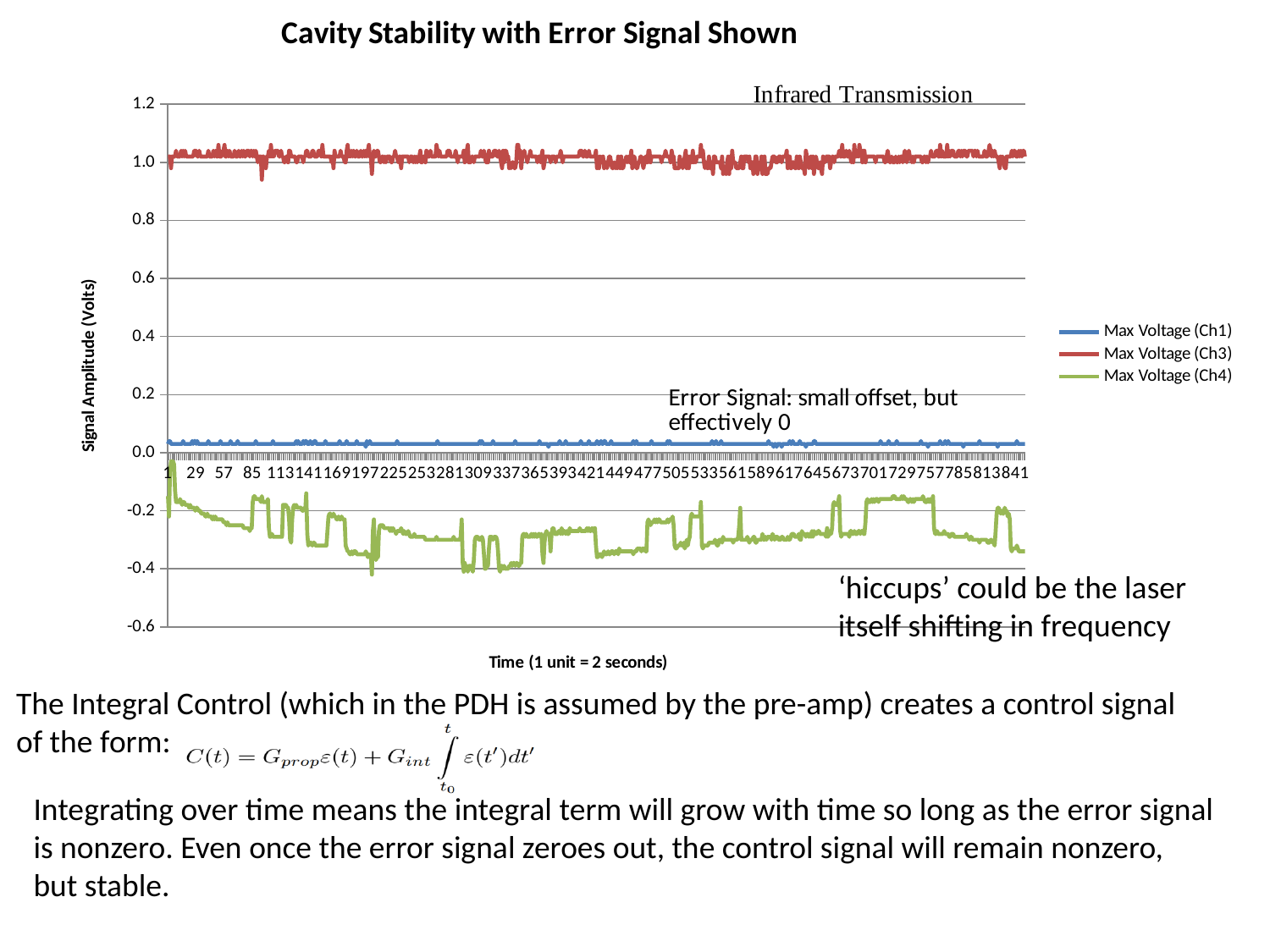
Are the values for Max Voltage (Ch4) greater or less than 0.0? less Are the values for Max Voltage (Ch3) greater or less than 0.8? greater Which series is plotted with the lowest values throughout the chart? Max Voltage (Ch4) Which series has larger values, Max Voltage (Ch3) or Max Voltage (Ch1)? Max Voltage (Ch3) Which series has larger values, Max Voltage (Ch1) or Max Voltage (Ch4)? Max Voltage (Ch1) Are the values for Max Voltage (Ch4) greater or less than -0.6? greater What kind of chart is shown on the slide? line chart What is the label of the vertical axis? Signal Amplitude (Volts) Which series is plotted with the highest values throughout the chart? Max Voltage (Ch3) What is the title of the chart? Cavity Stability with Error Signal Shown How many series does the legend list? 3